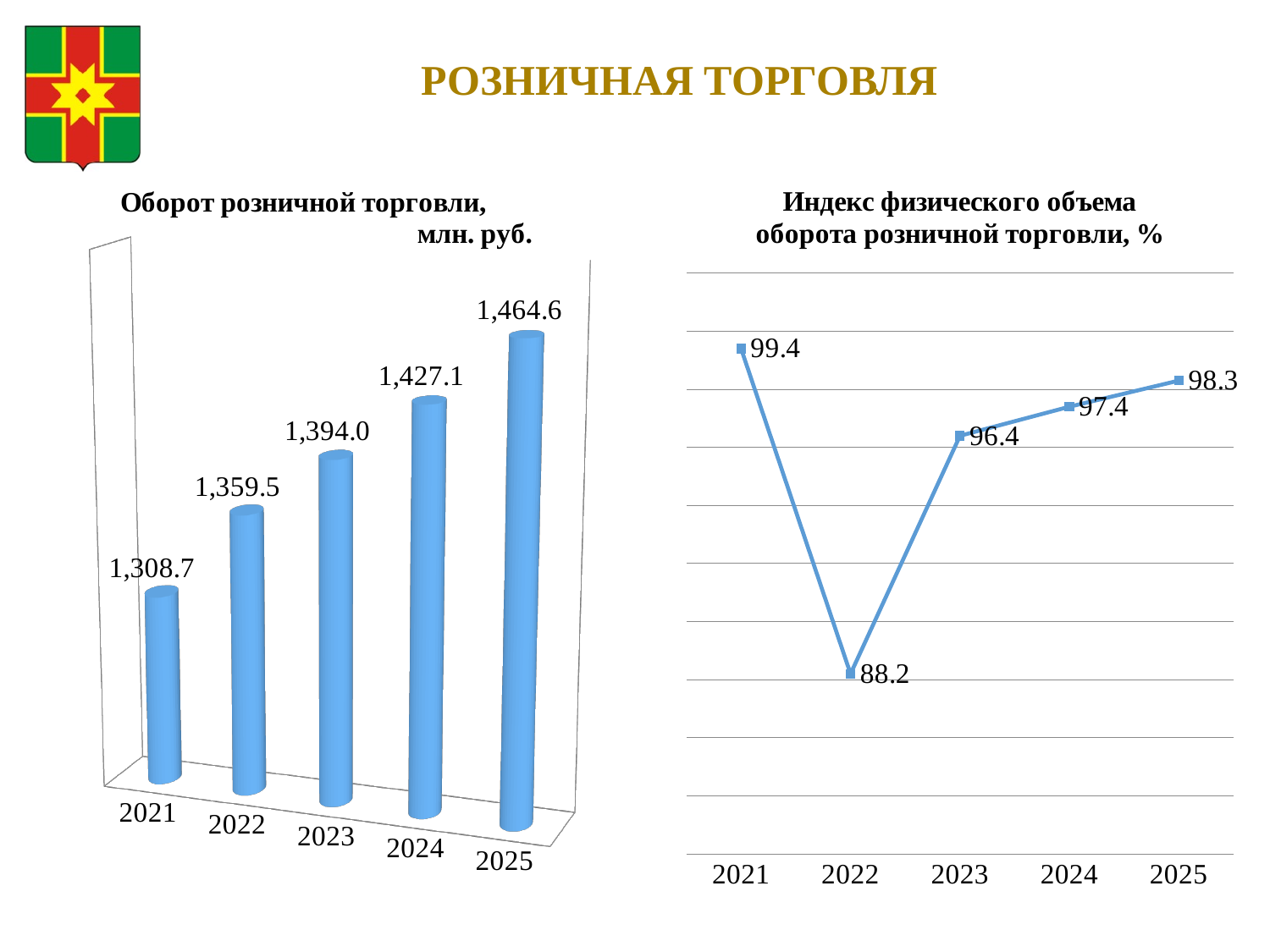
In the right chart (Индекс физического объема оборота розничной торговли, %), what is the value for 2022? 88.2 In the left chart (Оборот розничной торговли, млн. руб.), what is the value for 2023? 1,394.0 In the left chart (Оборот розничной торговли, млн. руб.), do the values rise or fall from 2021 to 2025? rise In the right chart (Индекс физического объема оборота розничной торговли, %), what is the value for 2025? 98.3 What kind of chart is the left chart (Оборот розничной торговли, млн. руб.)? bar chart In the right chart (Индекс физического объема оборота розничной торговли, %), what is the difference between the 2021 and 2022 values? 11.2 In the left chart (Оборот розничной торговли, млн. руб.), what is the value for 2021? 1,308.7 In the right chart (Индекс физического объема оборота розничной торговли, %), which is larger, the value for 2023 or the value for 2024? 2024 How many data points are plotted in the right chart (Индекс физического объема оборота розничной торговли, %)? 5 In the right chart (Индекс физического объема оборота розничной торговли, %), which year has the lowest value? 2022 In the left chart (Оборот розничной торговли, млн. руб.), what is the difference between the 2025 and 2021 values? 155.9 In the left chart (Оборот розничной торговли, млн. руб.), which year has the highest value? 2025